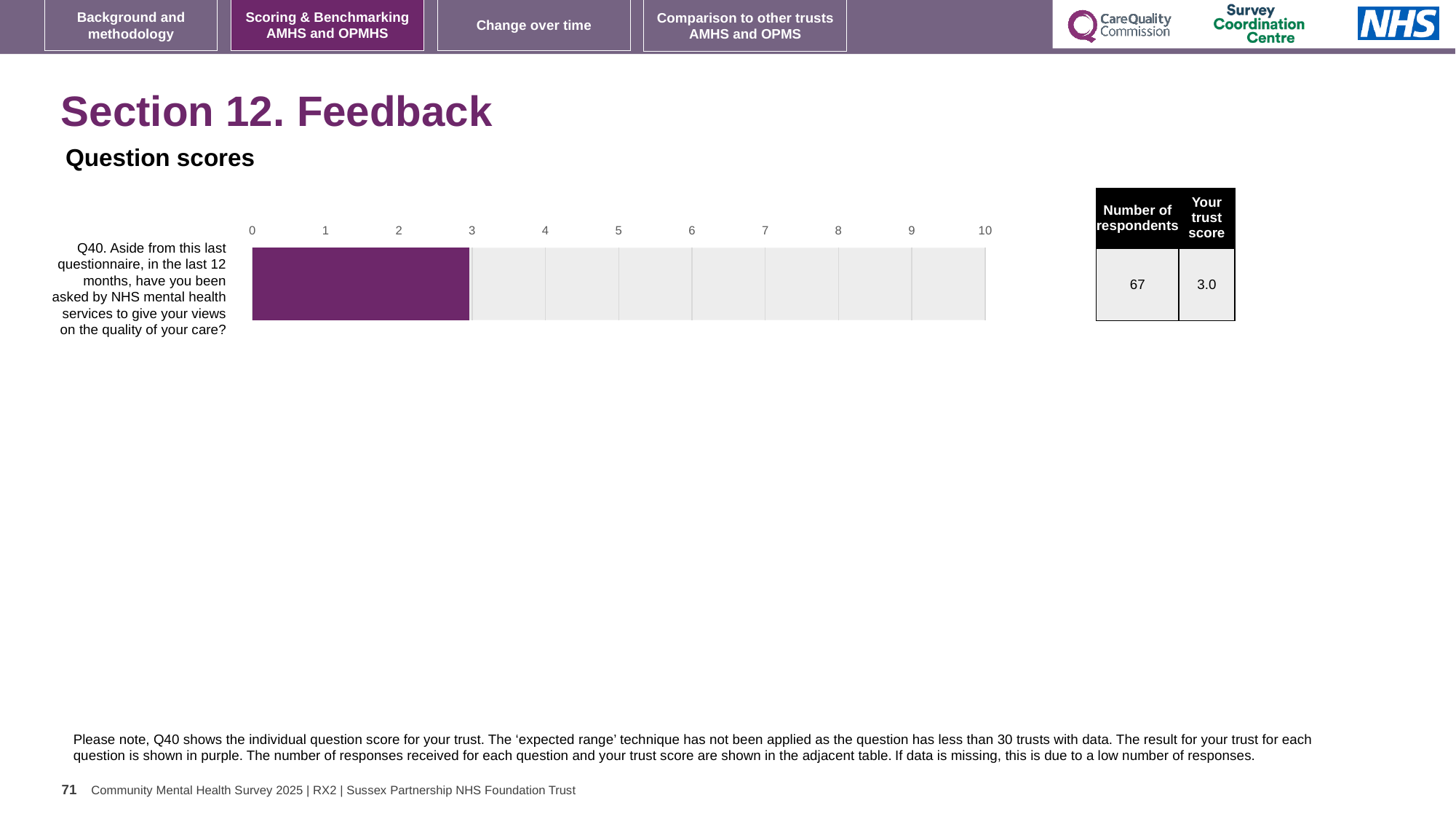
What kind of chart is shown on the slide? bar chart What is the highest value shown on the chart's axis? 10 Is the value for Q40 greater or less than 2? greater According to the adjacent table, how many respondents answered Q40? 67 How many questions (categories) are plotted in the chart? 1 What colour is the bar for Q40? purple What is the trust score for Q40 shown in the chart? 3.0 Is the value for Q40 greater or less than 5? less